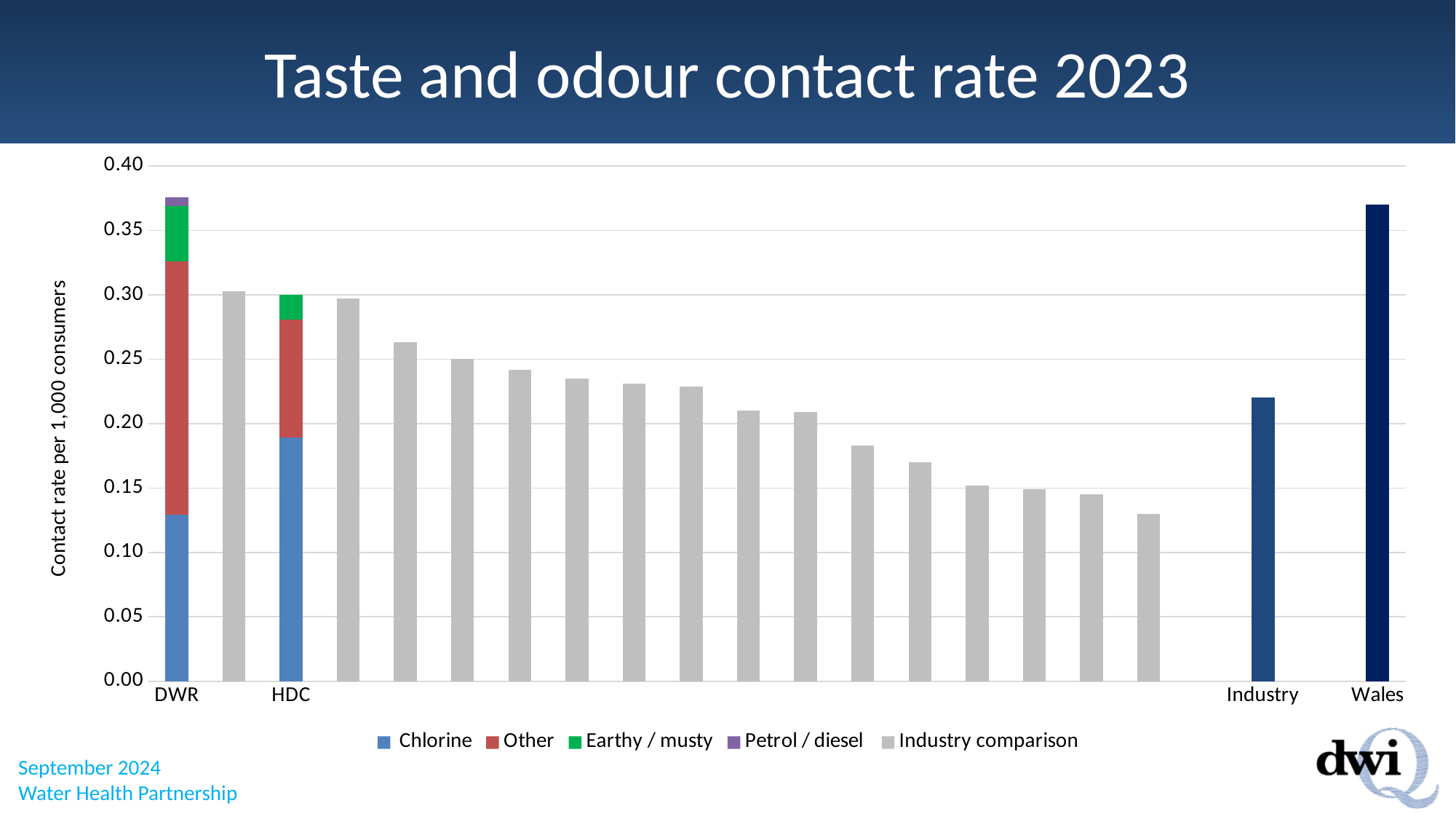
Which is larger, the total for DWR or the total for HDC? DWR Is the value for Wales greater or less than 0.35? greater Is the total value for DWR greater or less than 0.35? greater How many series does the legend list? 5 Which is larger, the total for HDC or the value for Industry? HDC Is the value for Industry greater or less than 0.20? greater What is the label of the y axis? Contact rate per 1,000 consumers Do the grey Industry comparison bars rise or fall from left to right? fall How many categories are labelled on the x axis? 4 Among the labelled categories DWR, HDC, Industry and Wales, which has the lowest value? Industry What kind of chart is shown on the slide? Stacked bar chart